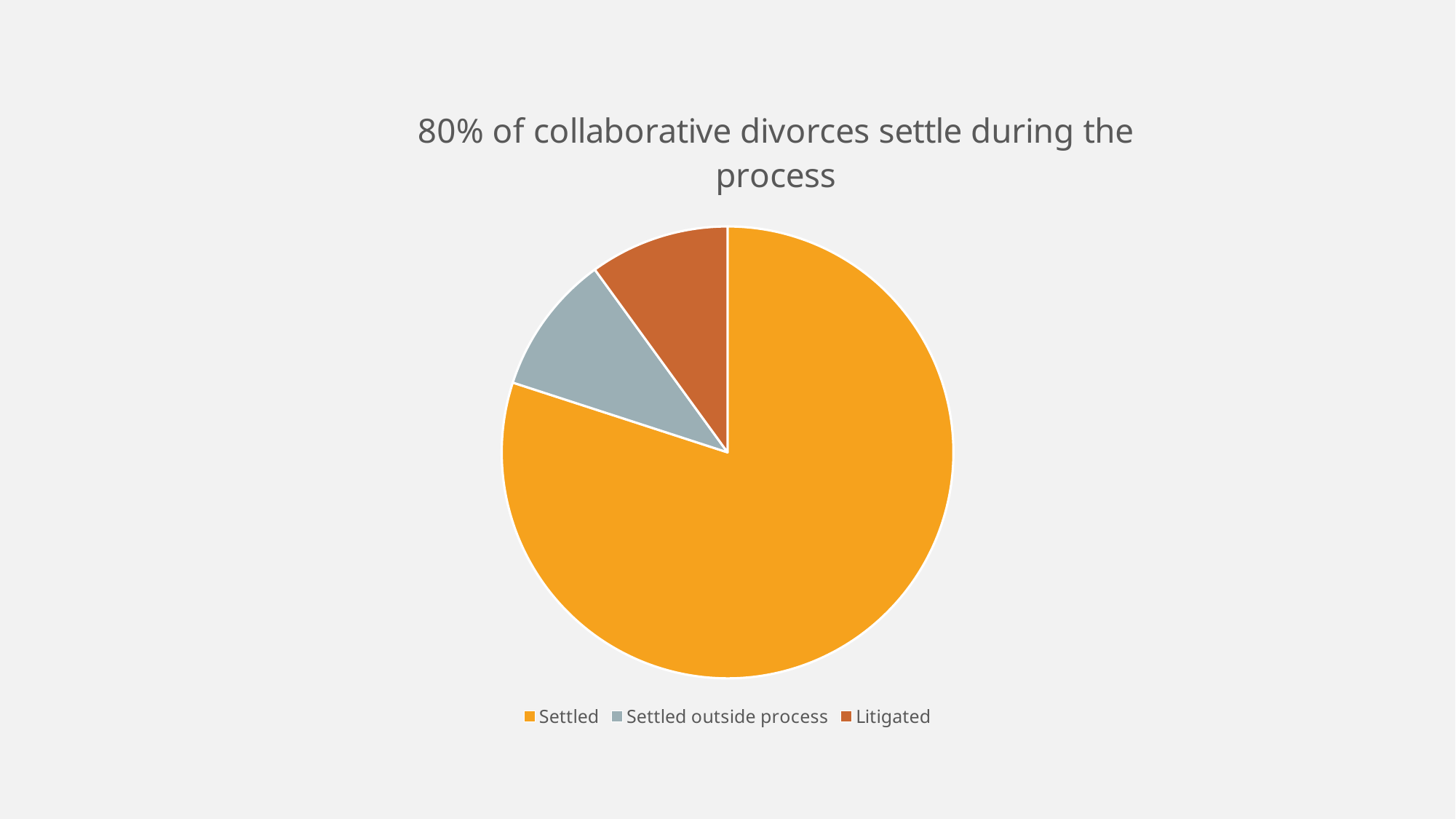
Which legend entry is shown in orange? Settled Which is larger, the Settled slice or the Settled outside process slice? Settled Does the Settled slice make up more or less than half of the pie? more What is the title of the chart? 80% of collaborative divorces settle during the process Which is larger, the Settled slice or the Litigated slice? Settled How many entries does the legend list? 3 Which category has the largest slice of the pie? Settled How many slices does the pie chart have? 3 What kind of chart is shown on the slide? pie chart According to the chart title, what share of collaborative divorces settle during the process? 80%